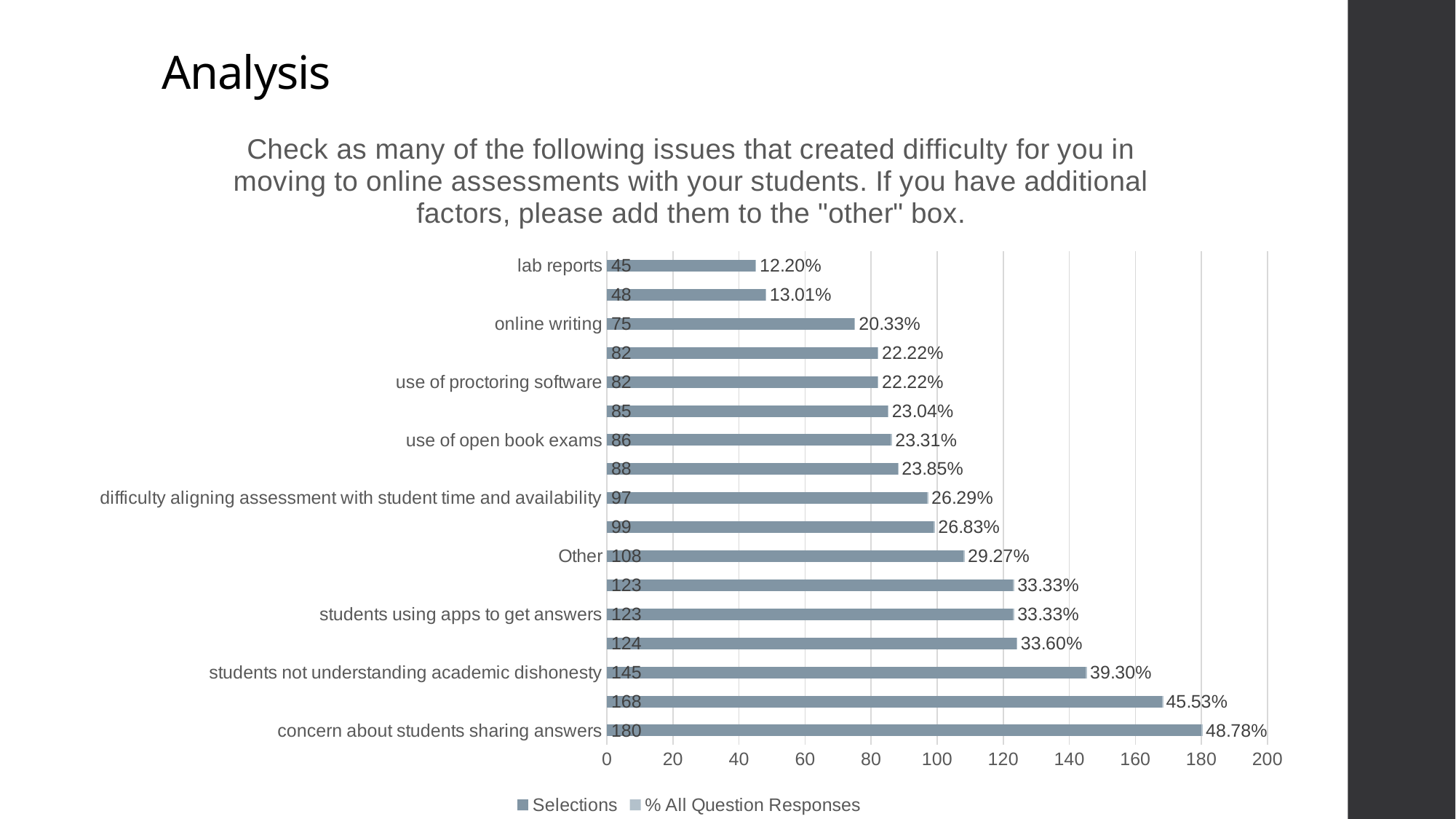
How many bars are plotted in the chart? 17 Which has more selections, "online writing" or "use of open book exams"? use of open book exams What is the difference in selections between "concern about students sharing answers" and "students not understanding academic dishonesty"? 35 How many series does the legend list? 2 Which labelled category has the lowest number of selections? lab reports What percentage of all question responses is shown for "Other"? 29.27% Is the number of selections for "students using apps to get answers" greater or less than 100? greater What kind of chart is shown on the slide? bar chart How many selections are shown for "students not understanding academic dishonesty"? 145 Which labelled category has the highest number of selections? concern about students sharing answers What percentage of all question responses is shown for "lab reports"? 12.20% How many selections are shown for "concern about students sharing answers"? 180